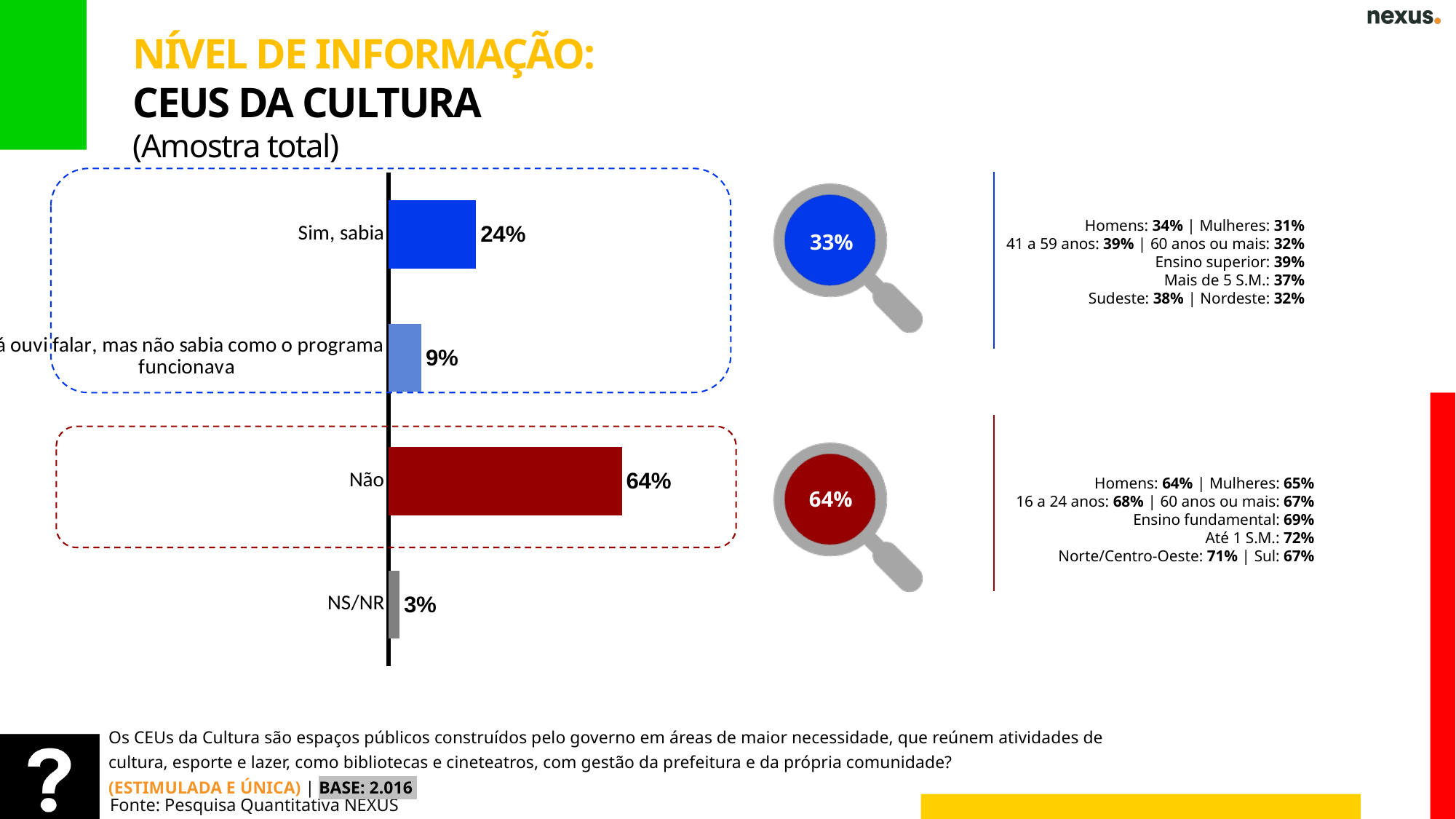
What is the difference between the values for "Não" and "Sim, sabia"? 40% What is the value for "NS/NR"? 3% What is the value for "Não"? 64% Which is larger, the value for "Sim, sabia" or the value for "Não"? Não Which category has the highest value? Não Which category has the lowest value? NS/NR How many categories are shown in the bar chart? 4 What is the value for the category "ouvi falar, mas não sabia como o programa funcionava"? 9% What percentage is shown inside the blue magnifying-glass circle next to the chart? 33% What is the value for "Sim, sabia"? 24% What kind of chart is shown on the slide? Bar chart What is the difference between the values for "Sim, sabia" and "NS/NR"? 21%